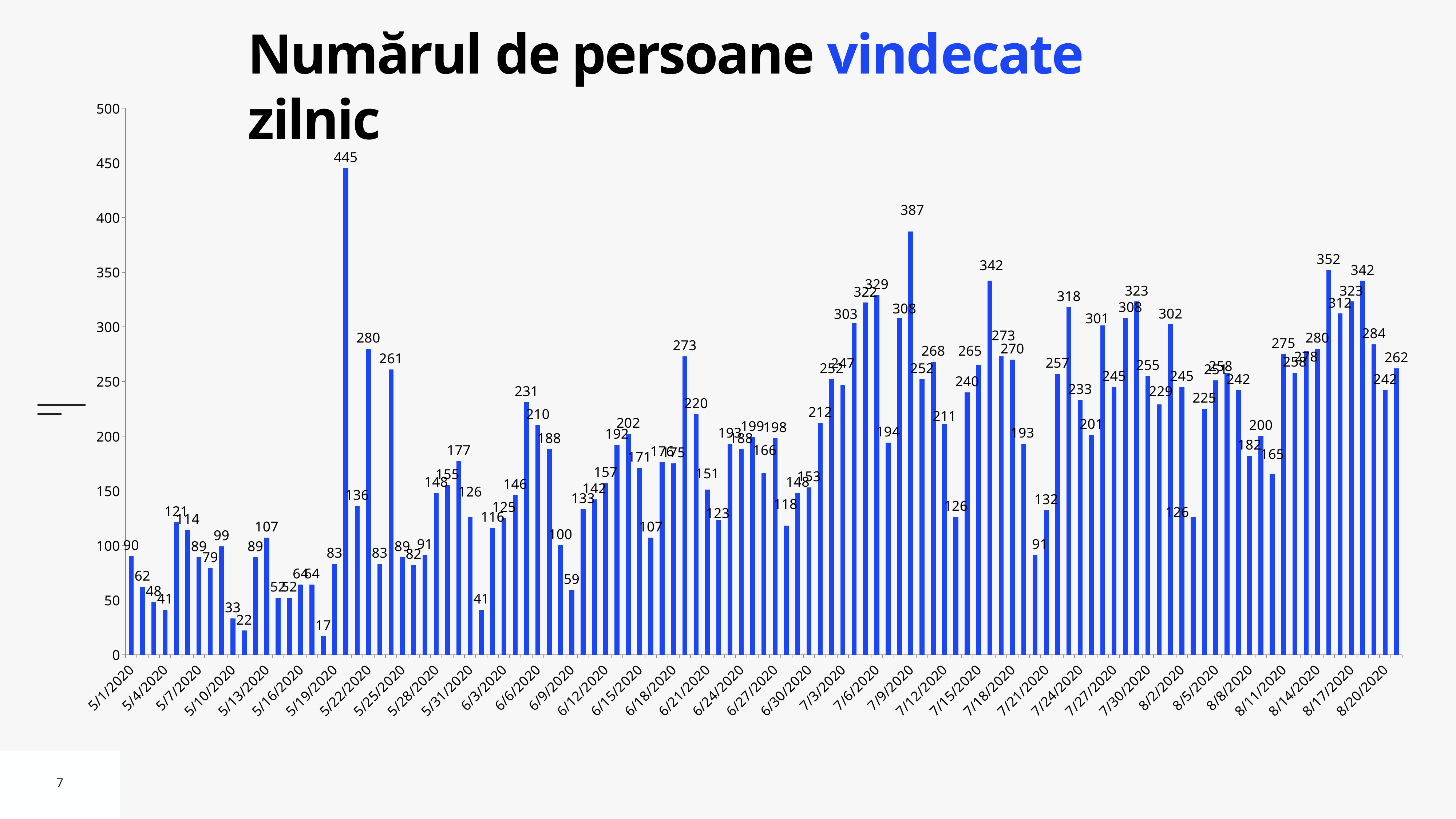
What is the highest value shown in the chart? 445 What is the value for 8/20/2020? 242 Is the value for 7/9/2020 greater or less than 350? greater What is the value for 5/22/2020? 280 What is the lowest value shown in the chart? 17 What is the value for 7/9/2020? 387 Which is larger, the value for 5/22/2020 or the value for 5/13/2020? 5/22/2020 What is the difference between the values for 8/14/2020 and 8/20/2020? 38 What kind of chart is shown on the slide? bar chart What is the value for 5/1/2020? 90 What is the value for 8/14/2020? 280 What is the title of the chart? Numărul de persoane vindecate zilnic